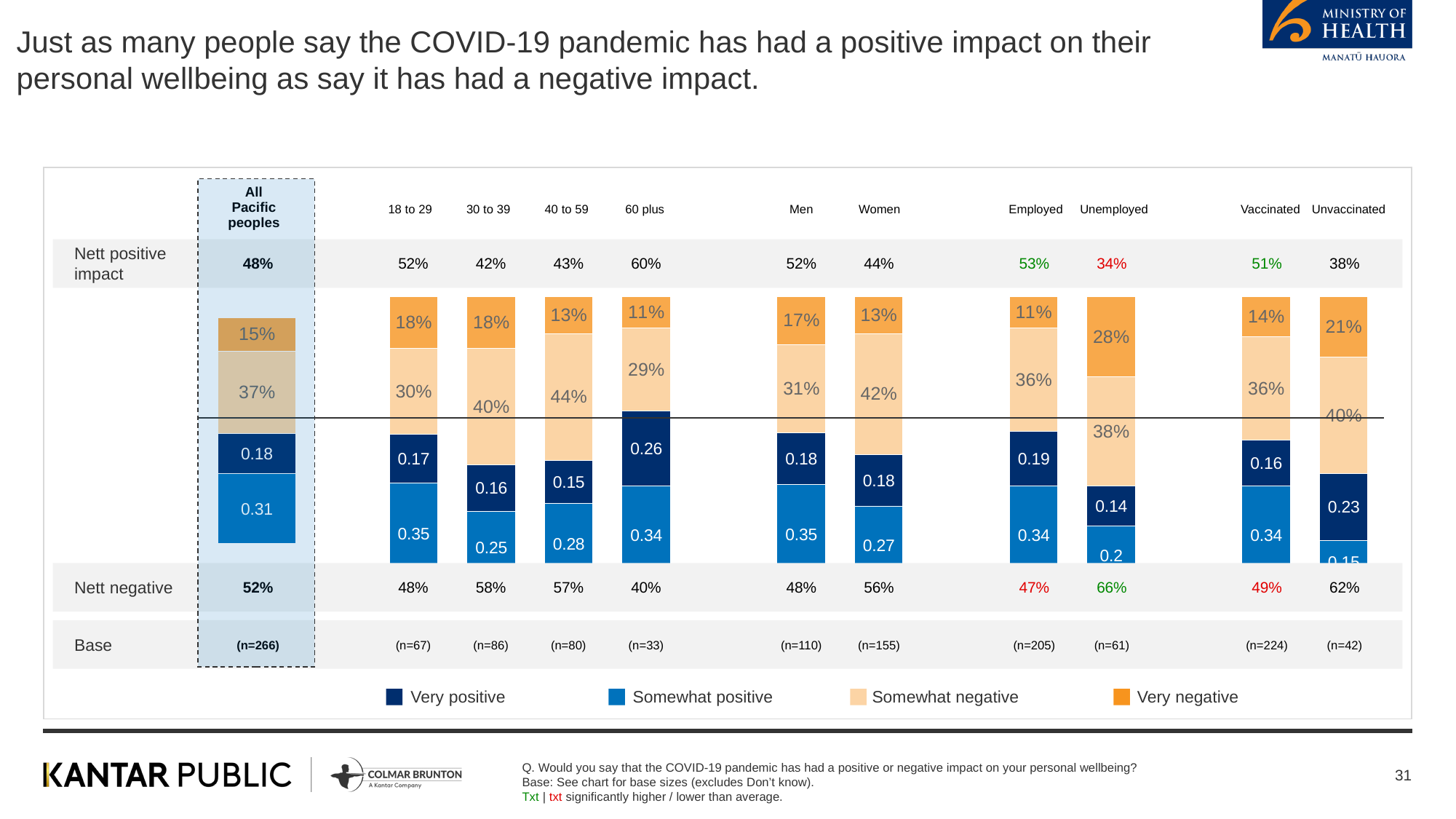
Which has a larger Somewhat negative value, Men or Women? Women Which group has the lowest Nett positive impact? Unemployed What kind of chart is shown on the slide? Stacked bar chart What is the difference in Nett positive impact between Men and Women? 8 percentage points How many series does the legend list? 4 What is the Somewhat positive value for the 18 to 29 group? 0.35 What is the Somewhat negative value for the 40 to 59 group? 44% Which group has the highest Very negative value? Unemployed What is the Very positive value for the 60 plus group? 0.26 What is the Nett negative value for Unemployed? 66% What is the Nett positive impact for the 60 plus group? 60% What is the Very negative value for Unemployed? 28%